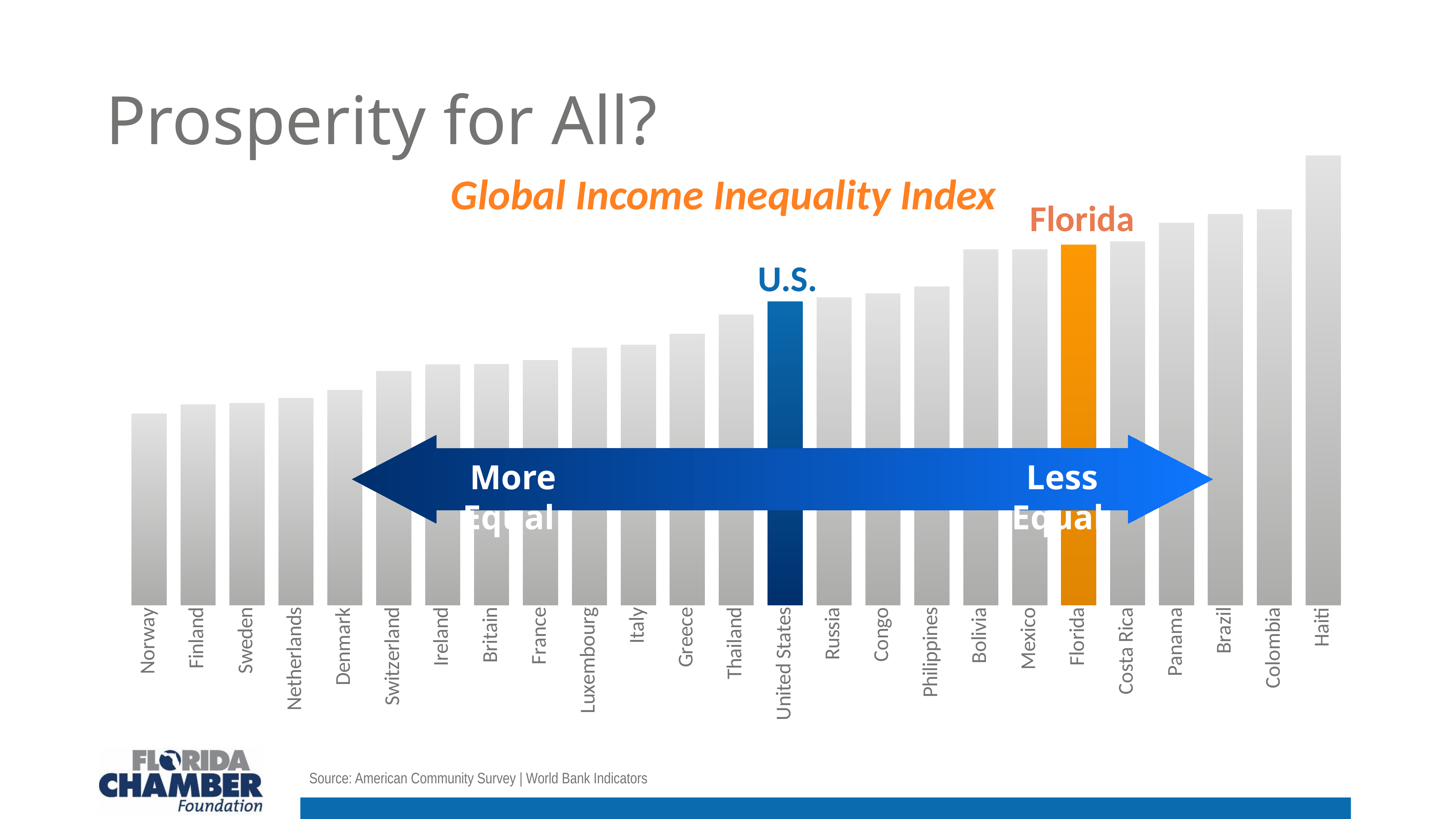
Which category is immediately to the right of the United States on the x axis? Russia What kind of chart is shown on the slide? Bar chart What is the title of the chart? Global Income Inequality Index Which category has the highest bar in the chart? Haiti What colour is the bar for Florida? Orange Which has the higher value, Florida or the United States? Florida Which has the higher value, Brazil or Mexico? Brazil Do the bar values rise or fall moving from left to right along the x axis? Rise How many countries or regions are shown as bars in the chart? 25 Which category has the lowest bar in the chart? Norway Which has the higher value, Denmark or Greece? Greece